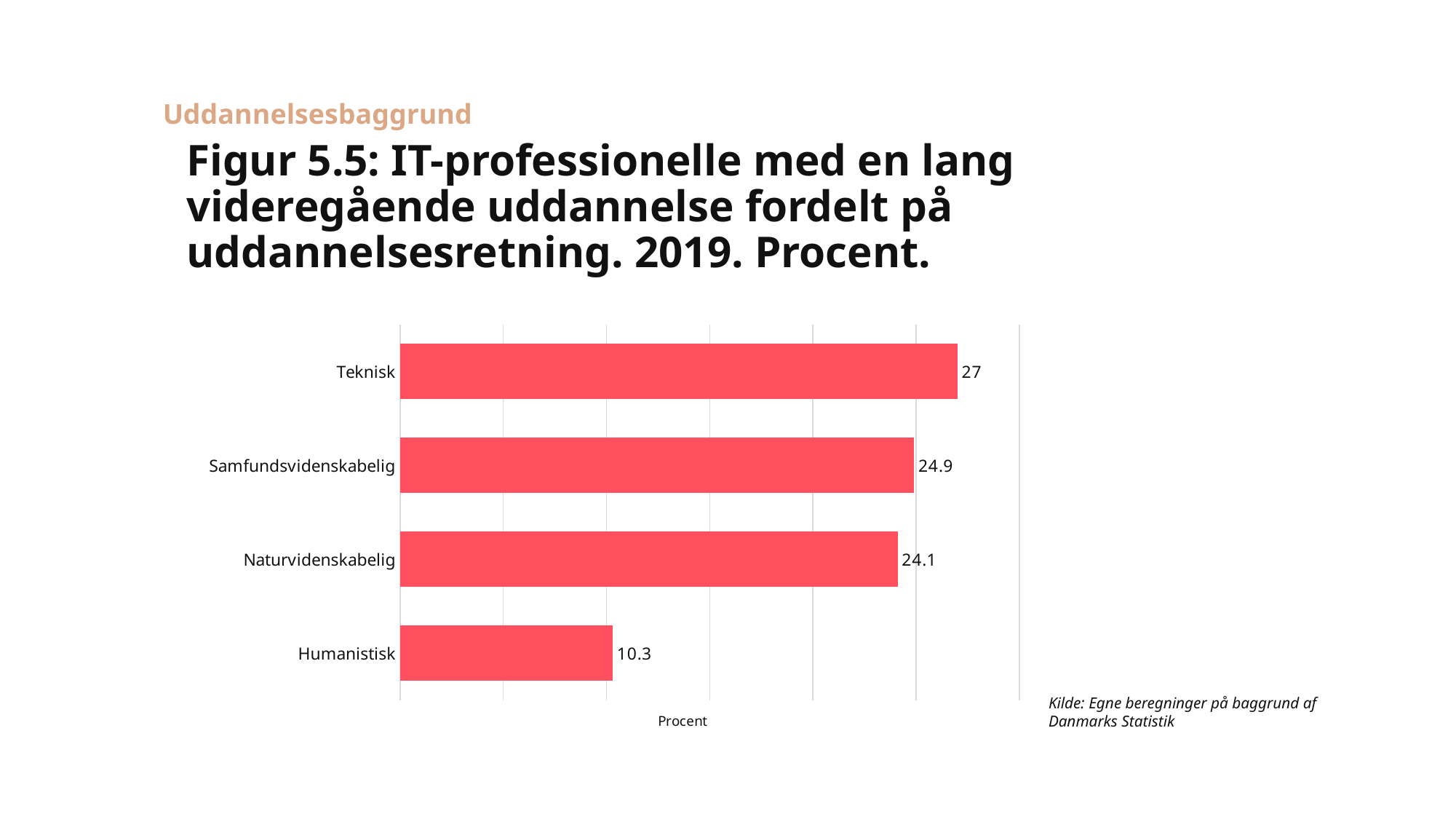
How many categories are shown in the chart? 4 What is the value for Samfundsvidenskabelig? 24.9 What is the value for Teknisk? 27 What is the value for Humanistisk? 10.3 Which is larger, the value for Teknisk or the value for Humanistisk? Teknisk What is the value for Naturvidenskabelig? 24.1 What is the label on the horizontal axis of the chart? Procent Which category has the highest value? Teknisk What is the difference between the values for Samfundsvidenskabelig and Naturvidenskabelig? 0.8 What is the difference between the values for Teknisk and Humanistisk? 16.7 What kind of chart is shown on the slide? Bar chart Which category has the lowest value? Humanistisk